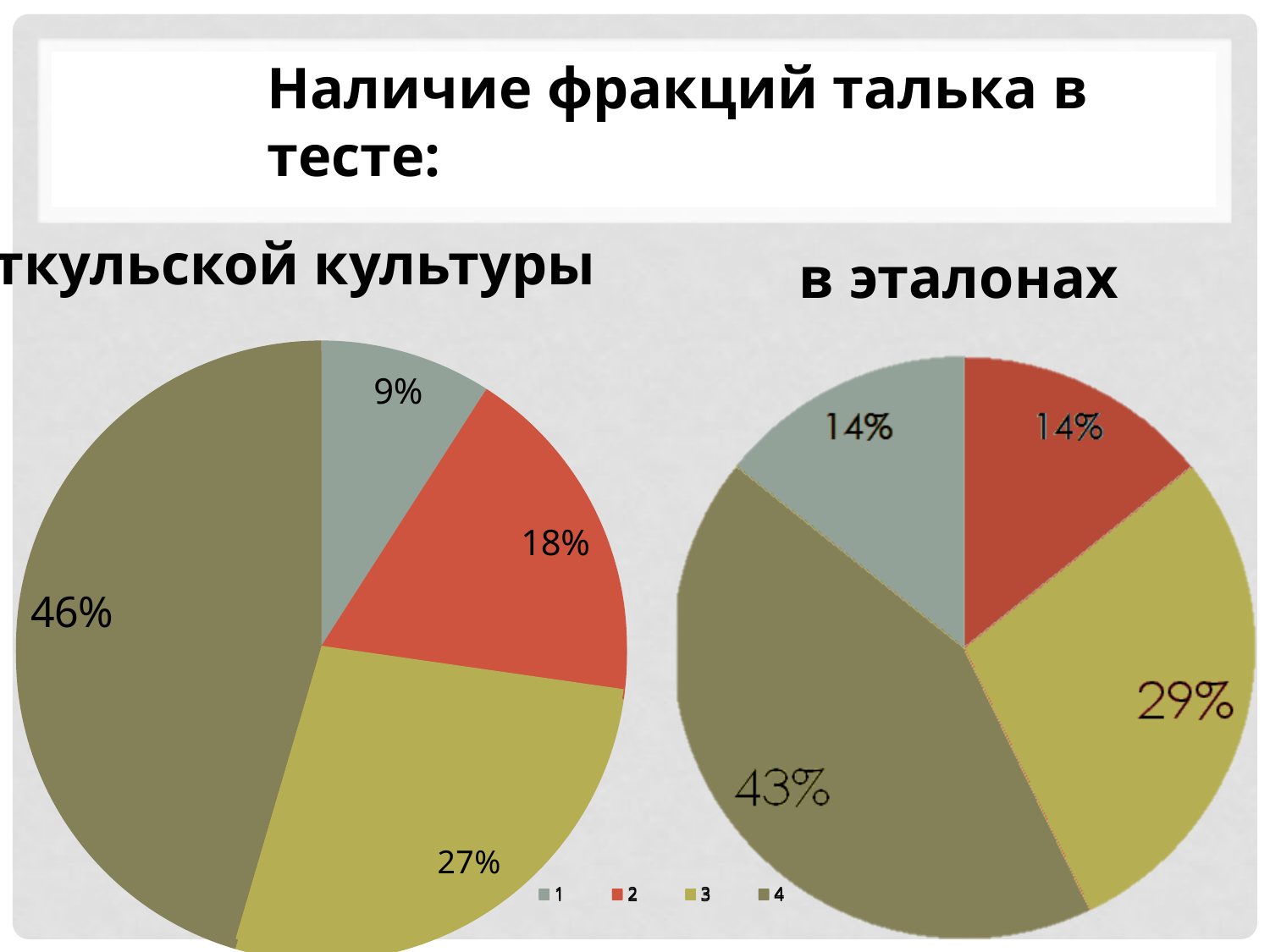
In the right pie chart (в эталонах), what is the difference between the shares of category 4 and category 3? 14% In the left pie chart, what is the difference between the shares of category 3 and category 2? 9% In the left pie chart, which category has the smallest share? 1 In the left pie chart, which category has the largest share? 4 In the left pie chart, what percentage is shown for category 4? 46% How many entries does the legend list? 4 What type of charts are shown on the slide? Pie charts Which is larger: the share of category 2 in the left pie chart or in the right pie chart (в эталонах)? Left pie chart In the left pie chart, what percentage is shown for category 1? 9% In the right pie chart (в эталонах), what percentage is shown for category 4? 43% In the right pie chart (в эталонах), which category has the largest share? 4 In the right pie chart (в эталонах), what percentage is shown for category 3? 29%